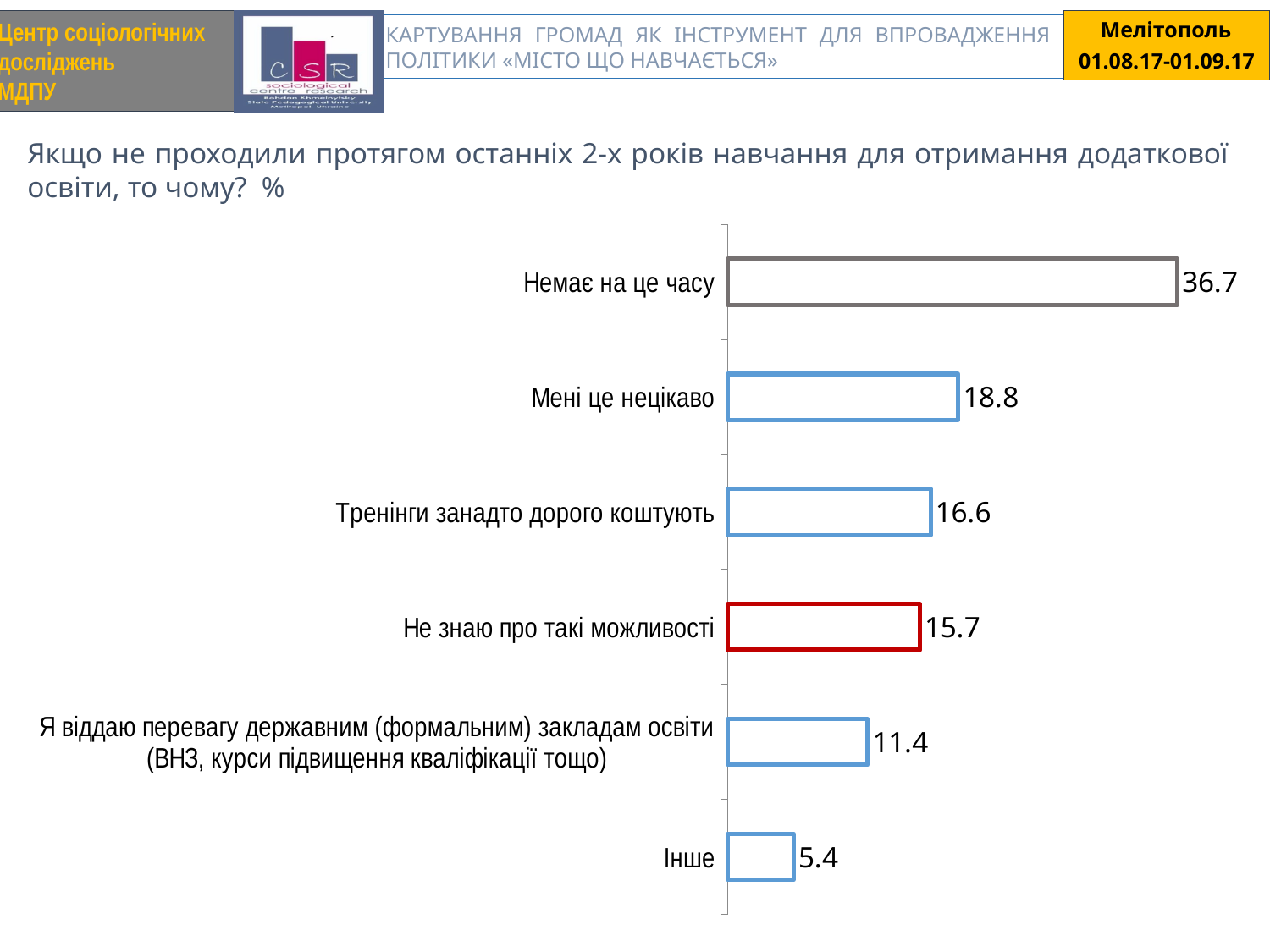
Which bar is outlined in red? Не знаю про такі можливості Which category has the highest value? Немає на це часу Which category has the lowest value? Інше What is the value for "Мені це нецікаво"? 18.8 What is the value for "Тренінги занадто дорого коштують"? 16.6 How many categories are shown in the chart? 6 What kind of chart is shown on the slide? Bar chart What is the value for "Інше"? 5.4 Which is larger: the value for "Тренінги занадто дорого коштують" or the value for "Я віддаю перевагу державним (формальним) закладам освіти (ВНЗ, курси підвищення кваліфікації тощо)"? Тренінги занадто дорого коштують What is the value for "Немає на це часу"? 36.7 What is the difference between the values for "Немає на це часу" and "Мені це нецікаво"? 17.9 What is the value for "Не знаю про такі можливості"? 15.7